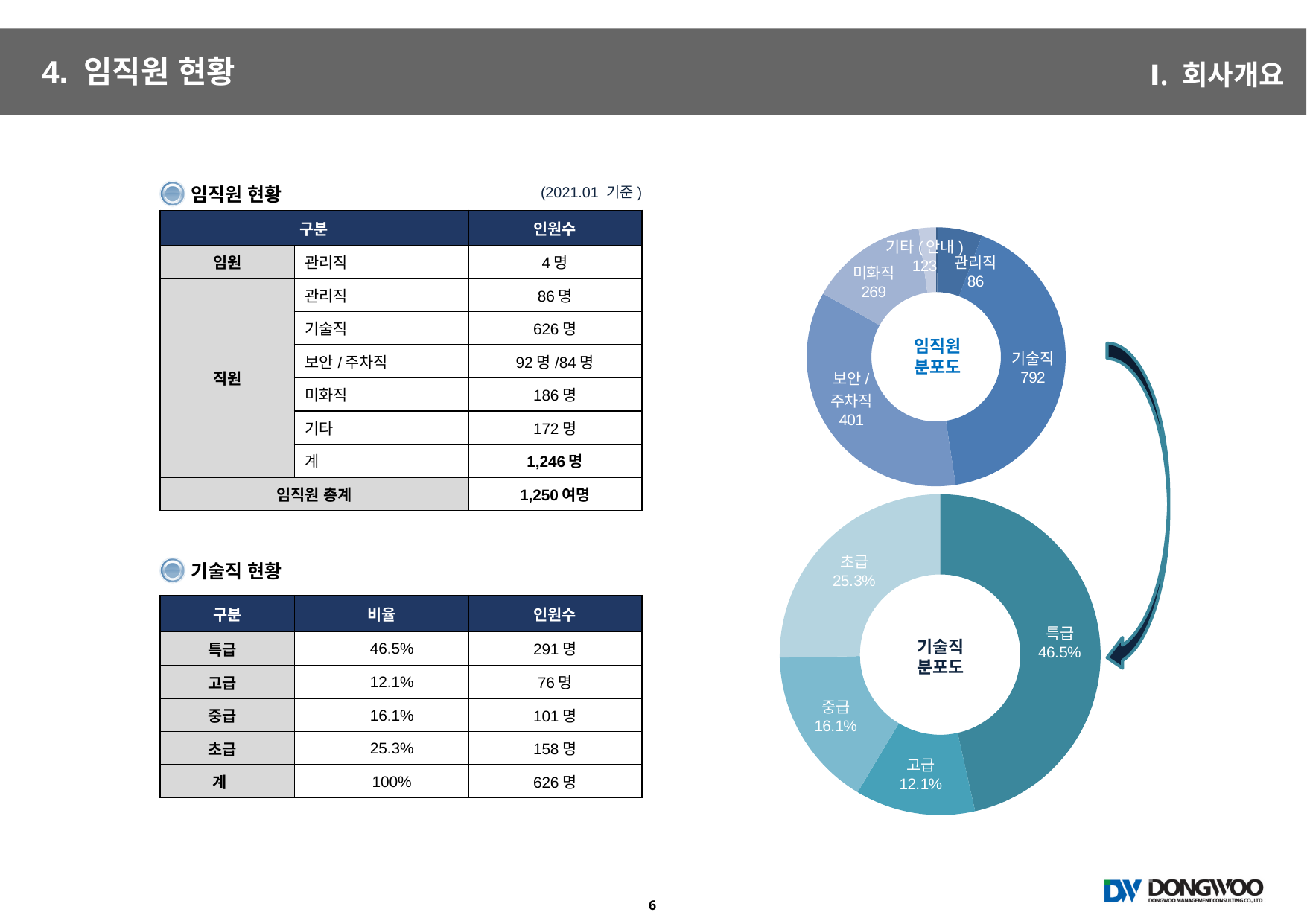
In the 임직원 분포도 chart, which category has the largest value? 기술직 In the 기술직 분포도 chart, what is the share for 특급? 46.5% In the 임직원 분포도 chart, how many categories are shown? 5 In the 임직원 분포도 chart, what is the value for 기술직? 792 In the 임직원 분포도 chart, what is the value for 보안 / 주차직? 401 In the 기술직 분포도 chart, what is the share for 초급? 25.3% What kind of chart is the 기술직 분포도 chart? doughnut chart In the 임직원 분포도 chart, which category has the smallest value? 관리직 In the 임직원 분포도 chart, what is the difference between the values for 기술직 and 보안 / 주차직? 391 In the 기술직 분포도 chart, which category has the smallest share? 고급 In the 임직원 분포도 chart, what is the value for 미화직? 269 In the 기술직 분포도 chart, which is larger, 중급 or 고급? 중급